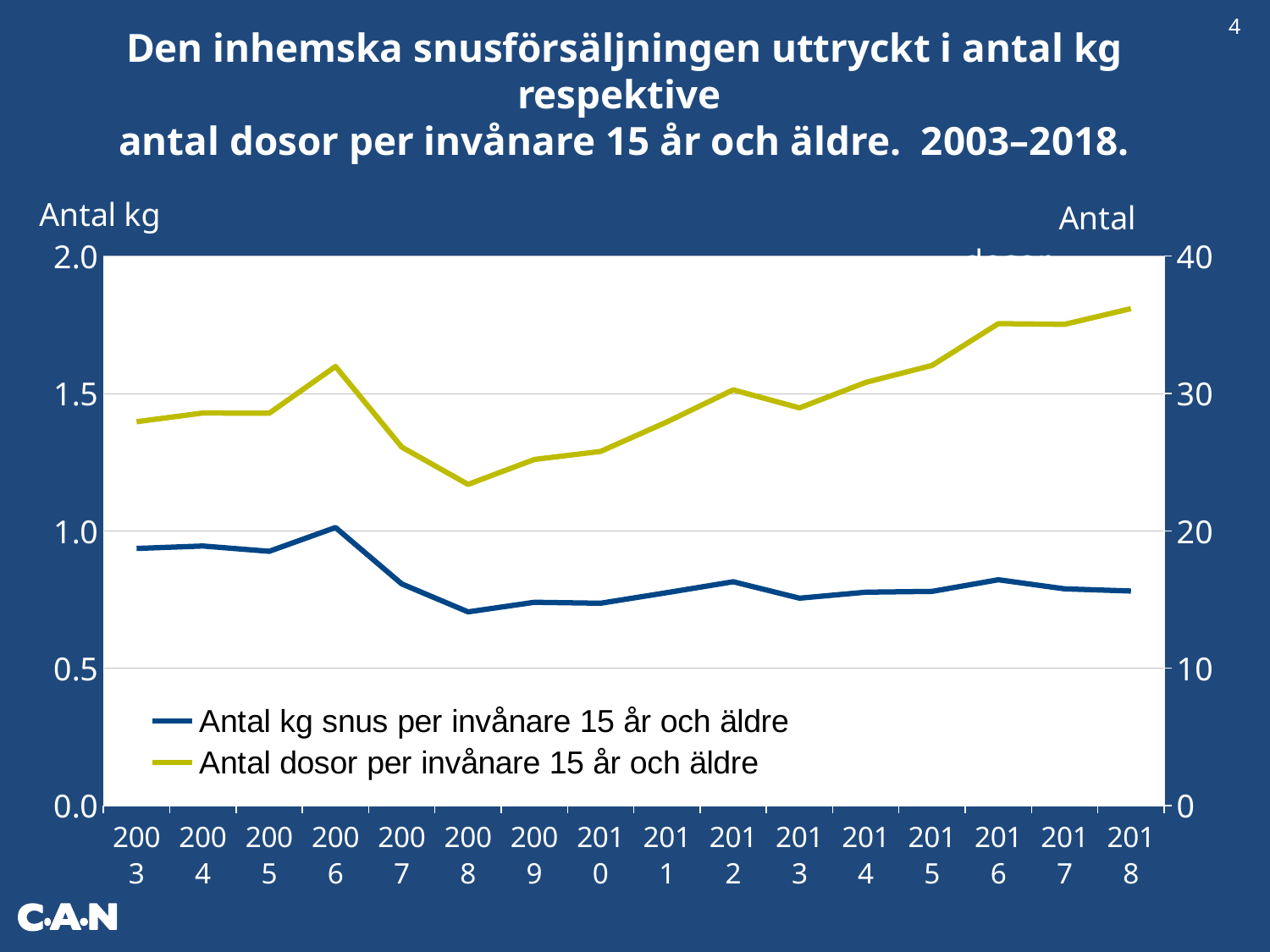
What is the label of the left vertical axis? Antal kg Which series is drawn in yellow-green? Antal dosor per invånare 15 år och äldre In which year is the value for Antal dosor per invånare 15 år och äldre lowest? 2008 Which is larger for Antal dosor per invånare 15 år och äldre: the value in 2006 or the value in 2008? 2006 Does the value for Antal dosor per invånare 15 år och äldre rise or fall from 2008 to 2018? rise How many series does the legend list? 2 In which year is the value for Antal dosor per invånare 15 år och äldre highest? 2018 In which year is the value for Antal kg snus per invånare 15 år och äldre highest? 2006 Is the value for Antal kg snus per invånare 15 år och äldre in 2008 greater or less than 1.0? less Is the value for Antal dosor per invånare 15 år och äldre in 2018 greater or less than 30? greater How many years are plotted along the x axis? 16 What kind of chart is shown on the slide? line chart